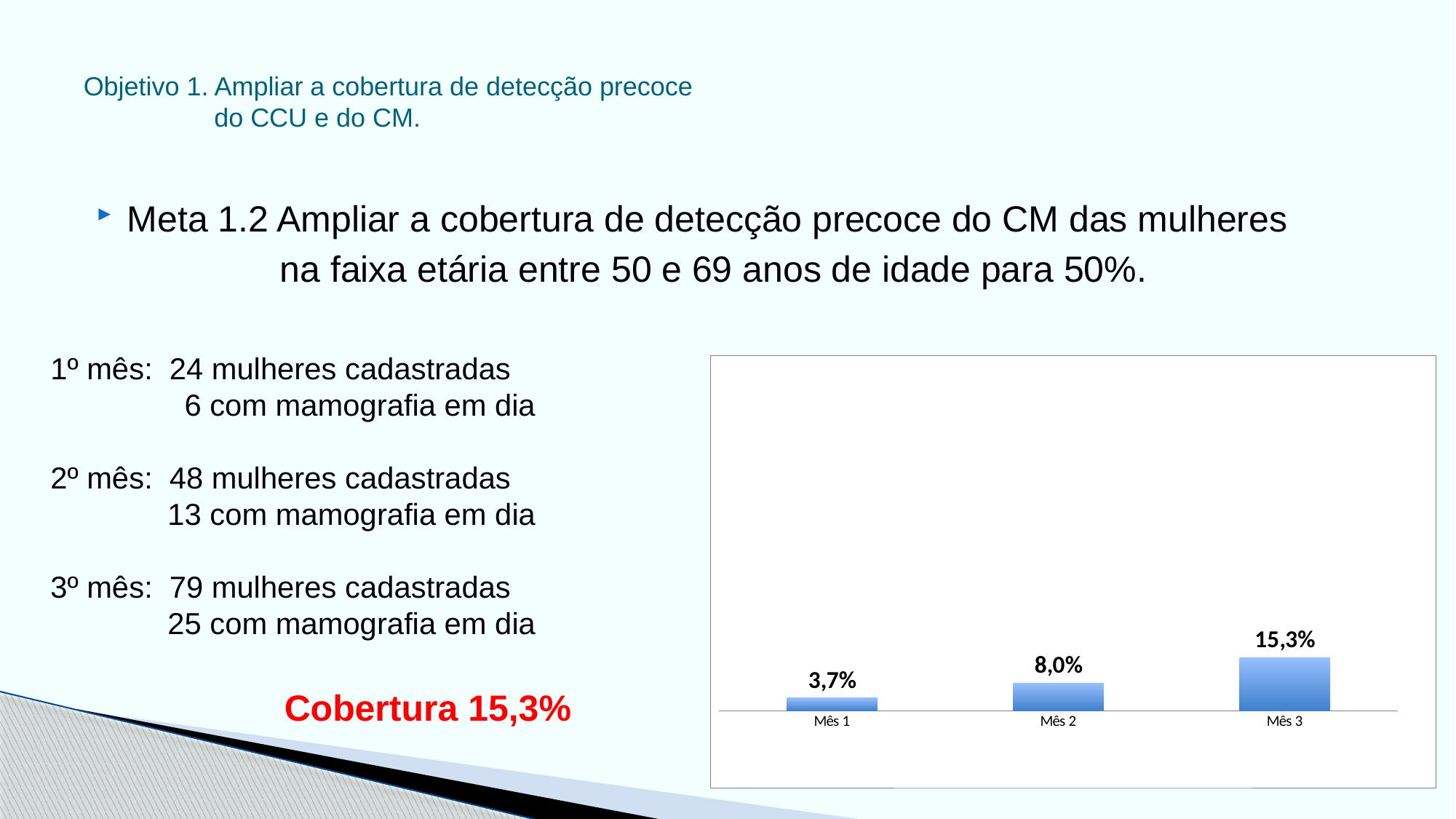
What kind of chart is shown on the slide? Bar chart What is the value shown for Mês 3? 15,3% Which is larger, the value for Mês 2 or the value for Mês 3? Mês 3 Do the values rise or fall from Mês 1 to Mês 3? Rise Which month has the lowest value? Mês 1 What colour are the bars in the chart? Blue What is the difference between the values for Mês 2 and Mês 1? 4,3% What is the difference between the values for Mês 3 and Mês 1? 11,6% What is the value shown for Mês 2? 8,0% What is the value shown for Mês 1? 3,7% How many months are plotted in the chart? 3 Which month has the highest value? Mês 3